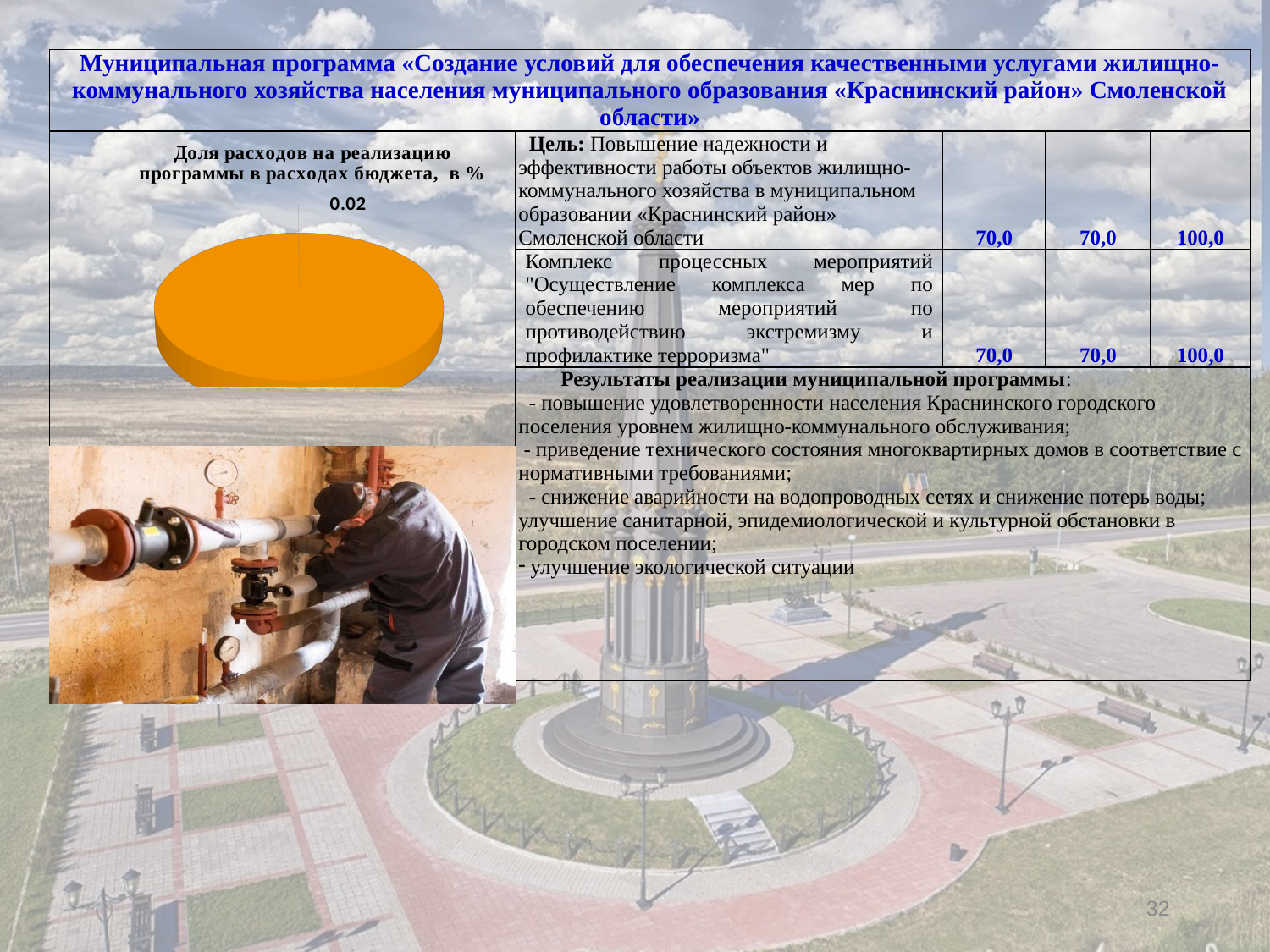
According to the pie chart, what is the share of programme expenditure in budget expenditure, in %? 0.02 What value is printed as the data label on the pie chart? 0.02 What kind of chart is shown on the slide? pie chart What is the title of the pie chart? Доля расходов на реализацию программы в расходах бюджета, в % What colour is the pie chart slice? orange